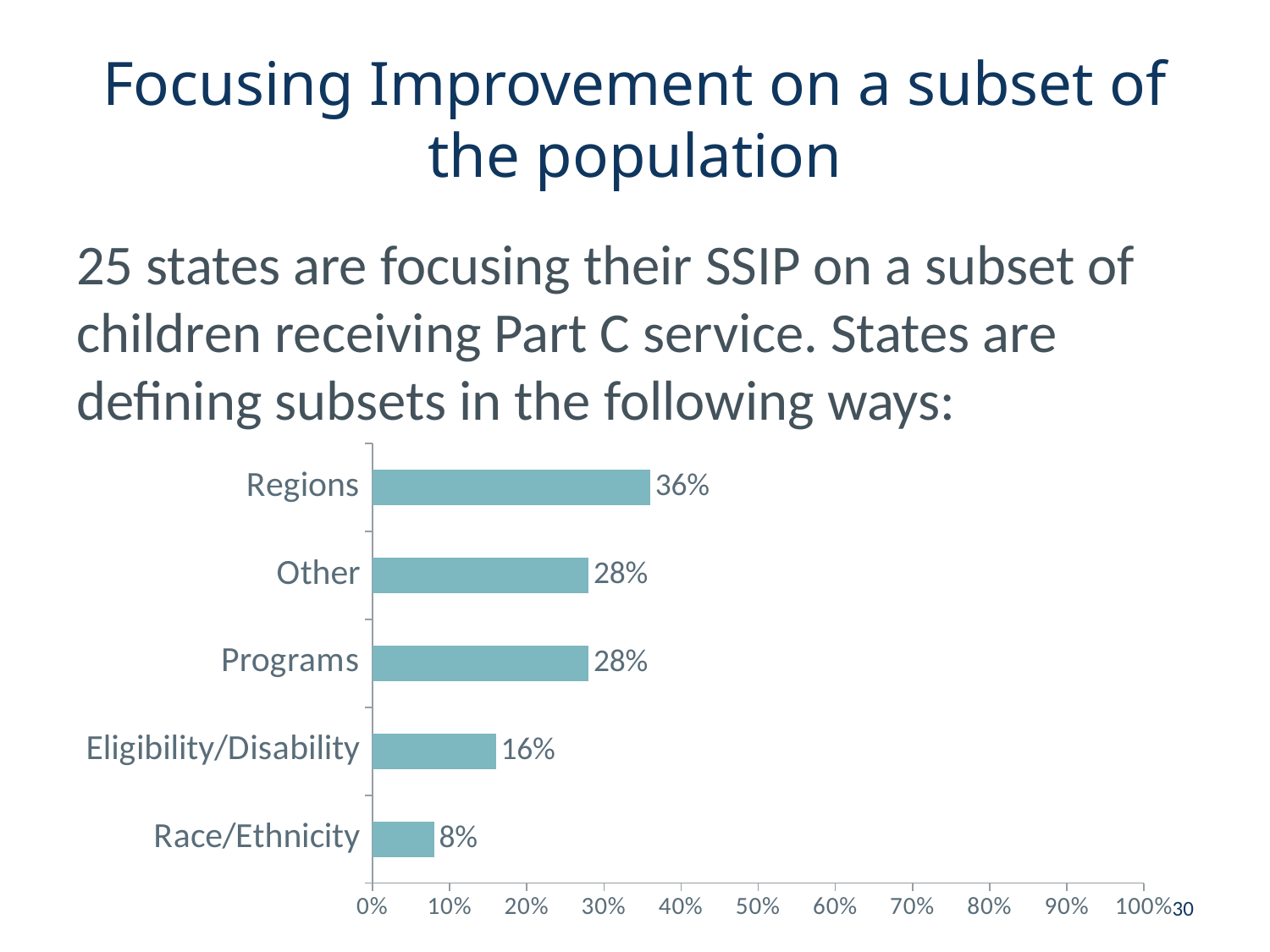
What is the value for Eligibility/Disability? 16% What is the difference between the values for Other and Eligibility/Disability? 12% Which category has the highest value? Regions What kind of chart is shown on the slide? bar chart Which is larger, the value for Regions or the value for Programs? Regions What is the value for Programs? 28% What is the difference between the values for Regions and Race/Ethnicity? 28% What is the value for Race/Ethnicity? 8% How many categories are shown in the chart? 5 Is the value for Eligibility/Disability greater or less than 20%? less Which category has the lowest value? Race/Ethnicity What percentage of states define their subset by Regions? 36%